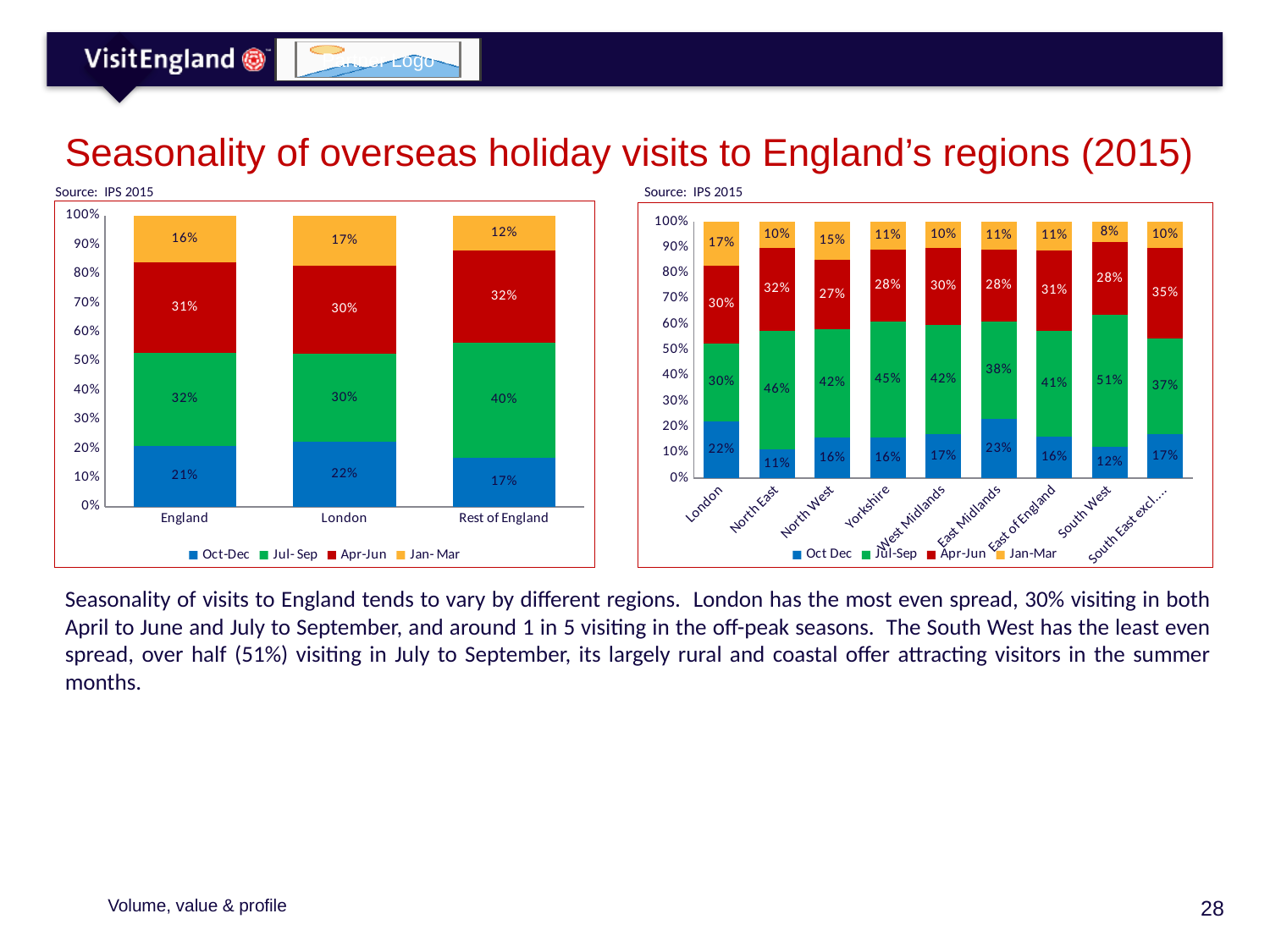
In the left chart, what is the Jul-Sep value for Rest of England? 40% How many regions are shown on the x axis of the right chart? 9 In the left chart, what is the Jan-Mar value for England? 16% In the right chart, what is the Oct Dec value for East Midlands? 23% How many series does the legend of the left chart list? 4 What type of chart is the left chart? Stacked bar chart In the right chart, which region has the lowest Jan-Mar value? South West In the right chart, what is the Jul-Sep value for South West? 51% In the right chart, which is larger: the Oct Dec value for North East or for North West? North West In the right chart, which region has the highest Jul-Sep value? South West In the right chart, what is the Apr-Jun value for North East? 32% In the left chart, what is the difference between the Jul-Sep values for Rest of England and London? 10%